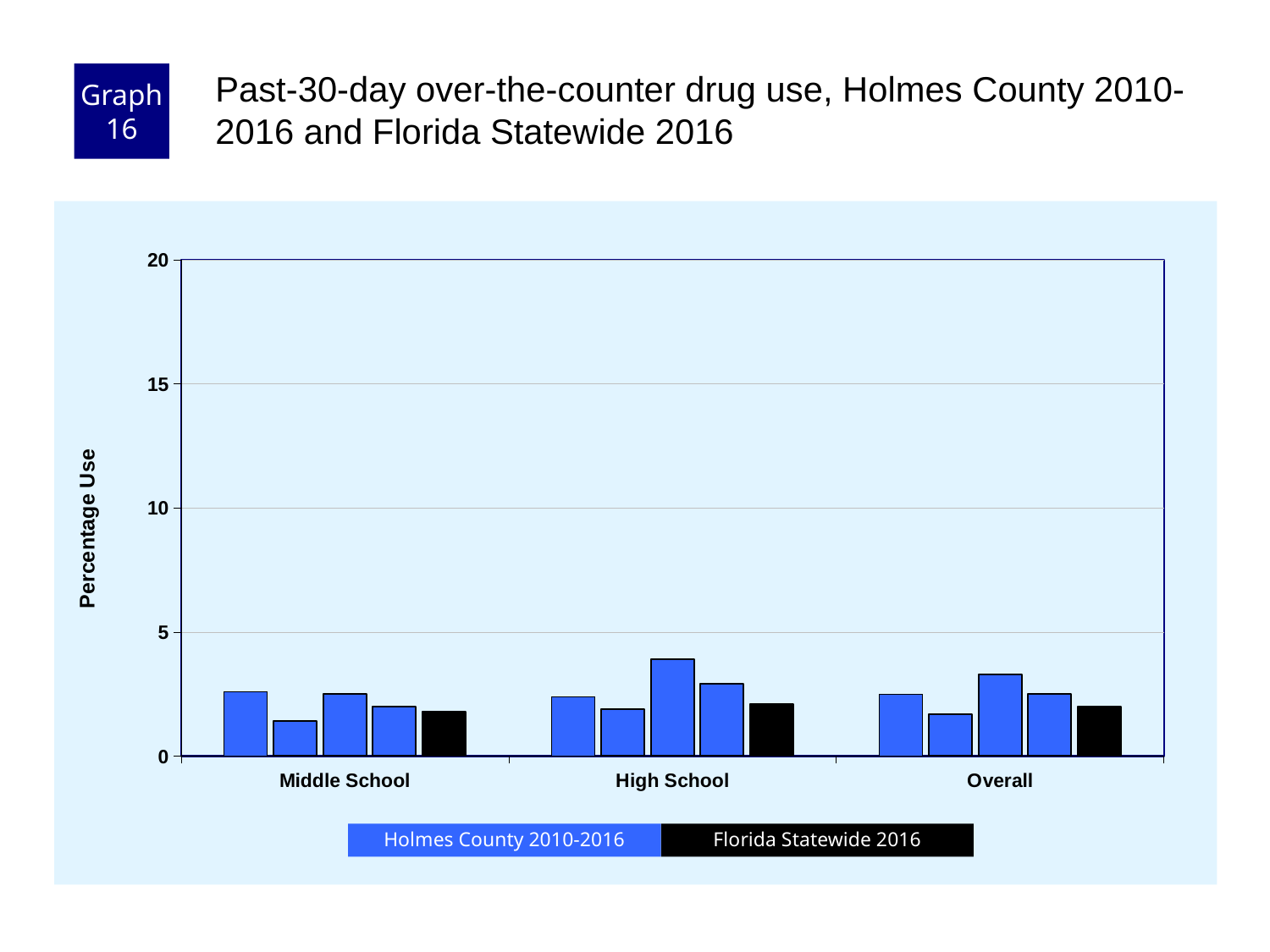
How many series does the legend list? 2 What is the label on the y axis? Percentage Use How many categories are shown on the x axis? 3 Is the Florida Statewide 2016 value for Overall greater or less than 5? less What is the title of the chart? Past-30-day over-the-counter drug use, Holmes County 2010-2016 and Florida Statewide 2016 Which category contains the tallest bar on the chart? High School Is the Florida Statewide 2016 value for High School greater or less than 5? less What kind of chart is shown on the slide? bar chart Is the Florida Statewide 2016 value for Middle School greater or less than 5? less What is the highest value shown on the y axis? 20